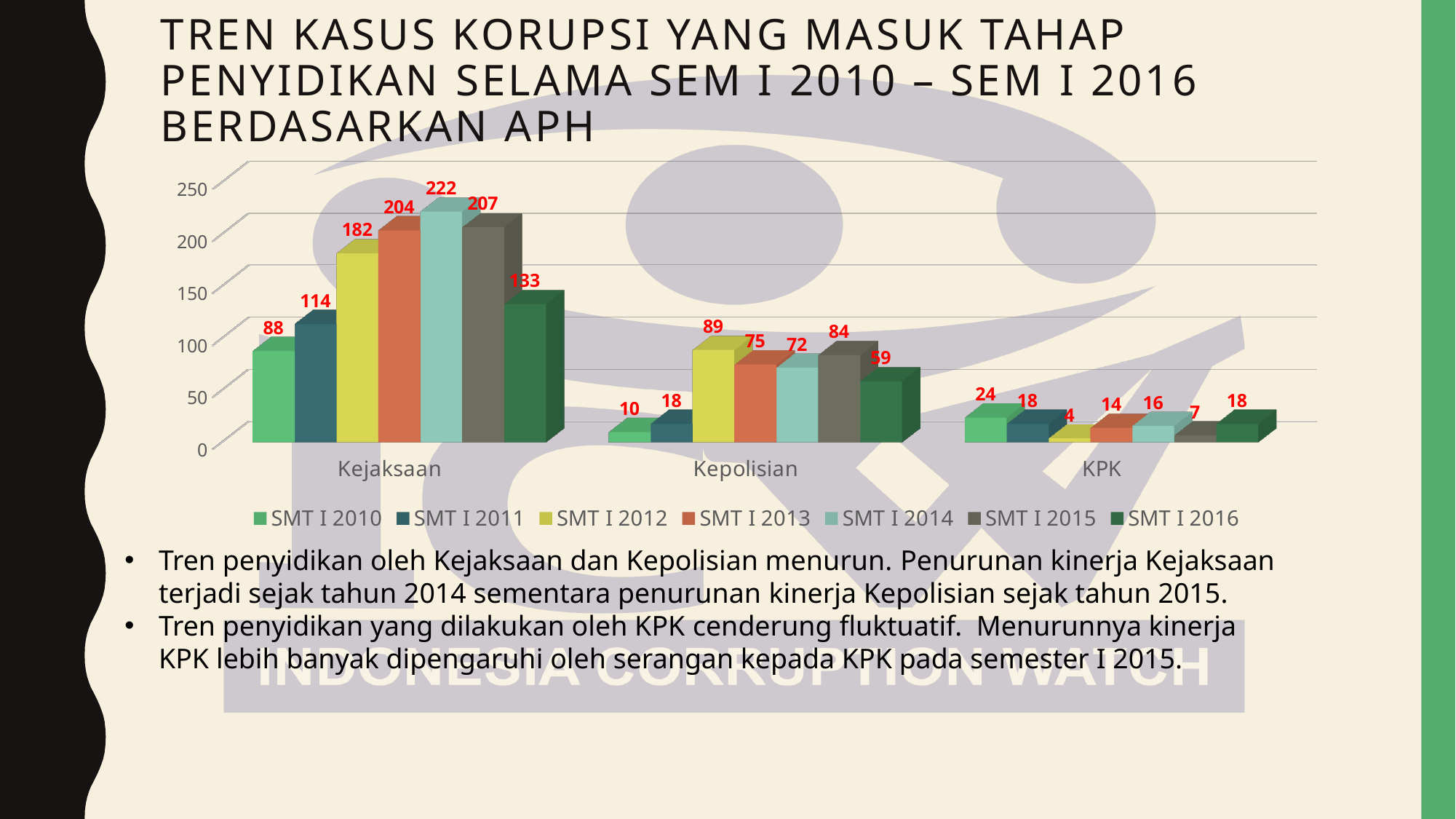
What is the value for KPK in SMT I 2013? 14 What is the value for Kepolisian in SMT I 2012? 89 Which series has the lowest value for KPK? SMT I 2012 Which is larger: the Kepolisian value for SMT I 2013 or for SMT I 2015? SMT I 2015 What kind of chart is shown on the slide? Bar chart What is the value for Kejaksaan in SMT I 2014? 222 Is the value for Kejaksaan in SMT I 2012 greater or less than 150? greater Which category is labelled in the middle of the x axis? Kepolisian How many series does the legend list? 7 Which series has the highest value for Kejaksaan? SMT I 2014 How many categories are shown on the x axis? 3 What is the difference between the Kejaksaan values for SMT I 2014 and SMT I 2016? 89